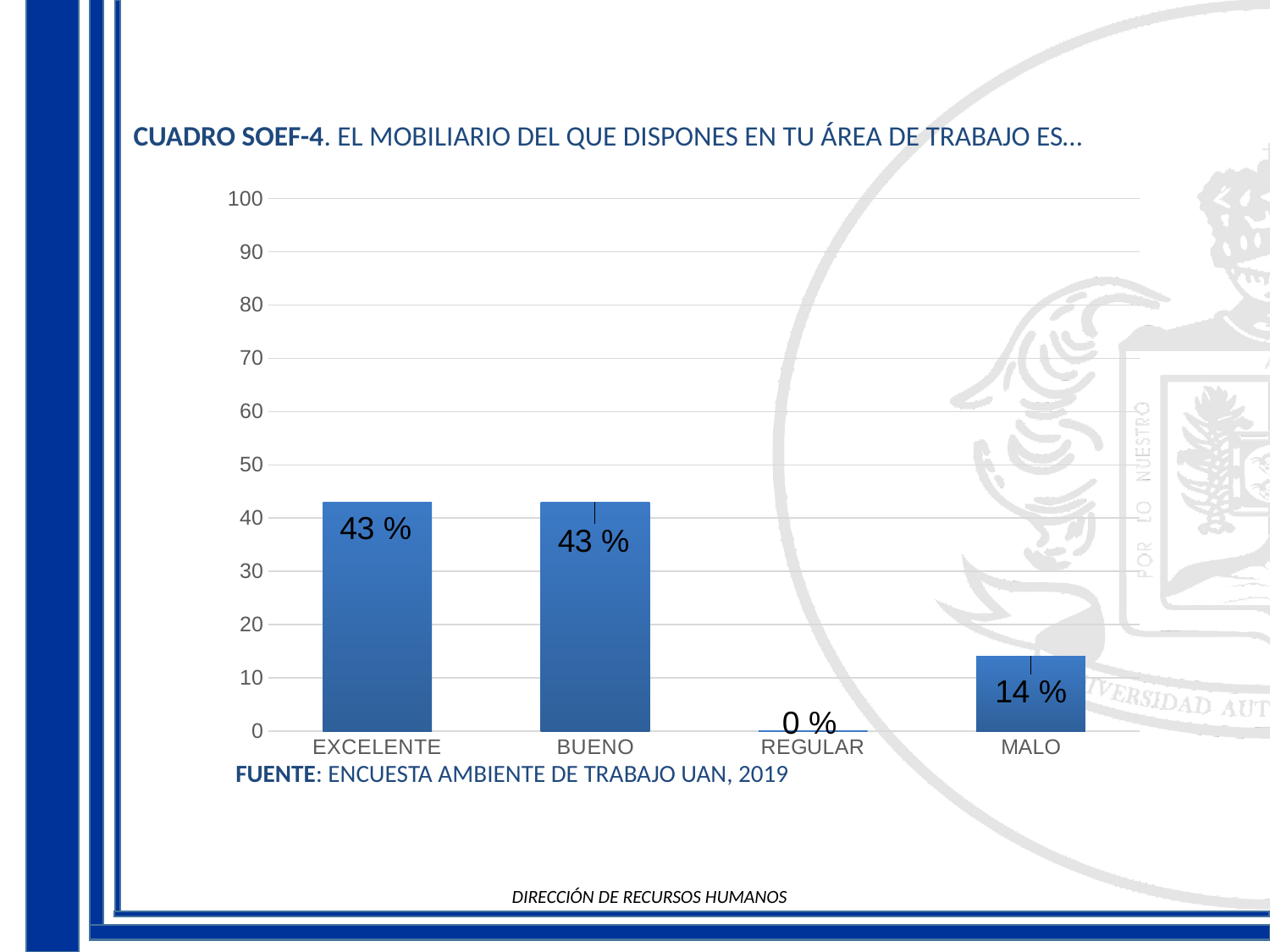
What is the value for REGULAR? 0 % Which category has the lowest value? REGULAR How many categories are shown on the x axis? 4 What is the highest value shown on the y axis? 100 What is the difference between the values for EXCELENTE and MALO? 29 % Which is larger, the value for MALO or the value for REGULAR? MALO What is the value for BUENO? 43 % What is the value for MALO? 14 % Is the value for BUENO greater or less than 40? greater What source is cited below the chart? ENCUESTA AMBIENTE DE TRABAJO UAN, 2019 What kind of chart is shown on the slide? bar chart What is the value for EXCELENTE? 43 %